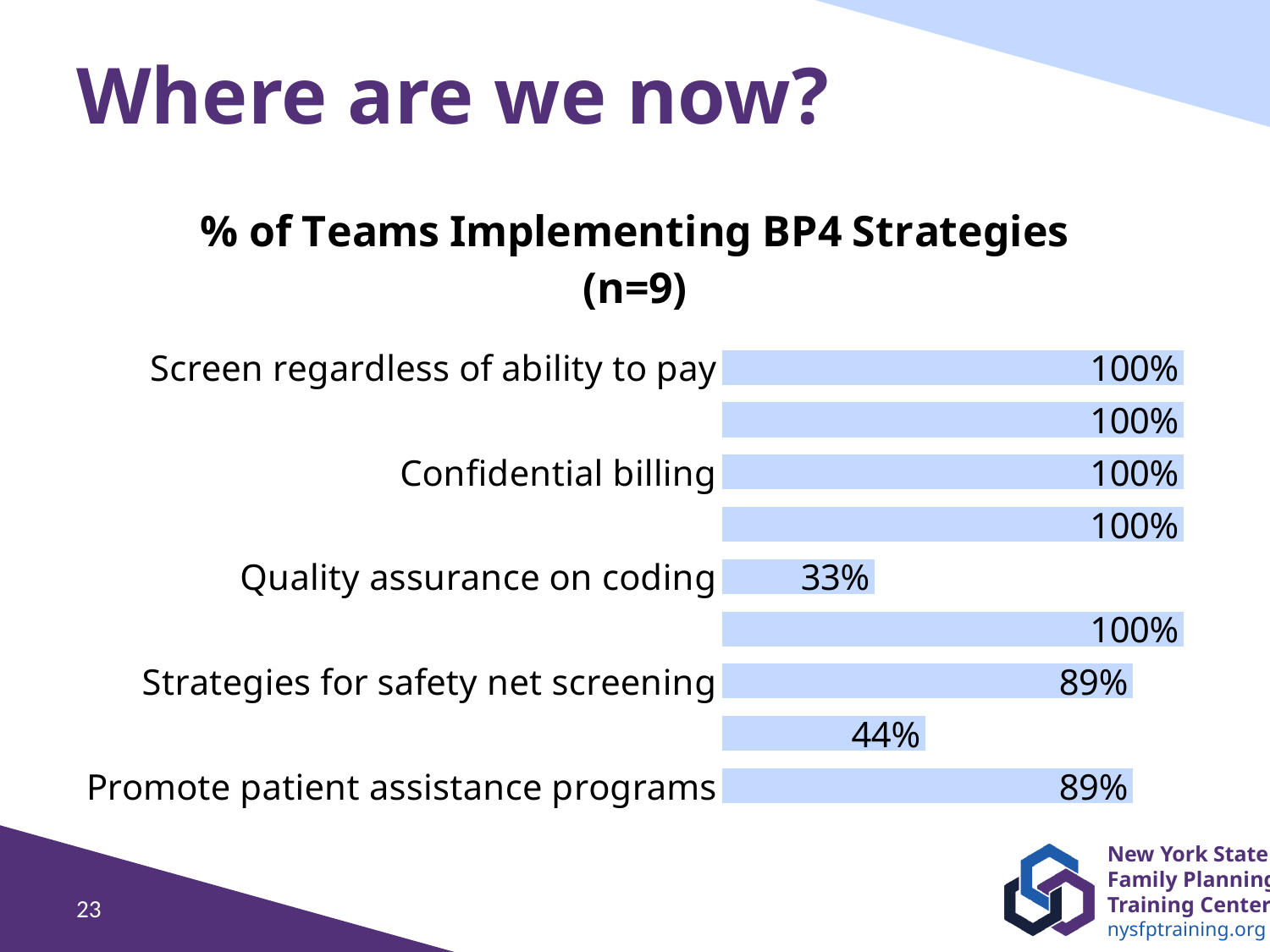
Which is larger, the value for Confidential billing or the value for Quality assurance on coding? Confidential billing What is the highest value shown on any bar in the chart? 100% What is the title of the chart? % of Teams Implementing BP4 Strategies (n=9) What is the value for Screen regardless of ability to pay? 100% Which category has the lowest value in the chart? Quality assurance on coding What is the value for Confidential billing? 100% What is the difference in percentage points between Screen regardless of ability to pay and Quality assurance on coding? 67 percentage points What is the value for Quality assurance on coding? 33% How many bars are plotted in the chart? 9 What kind of chart is shown on the slide? Bar chart What is the value for Promote patient assistance programs? 89% What is the value for Strategies for safety net screening? 89%